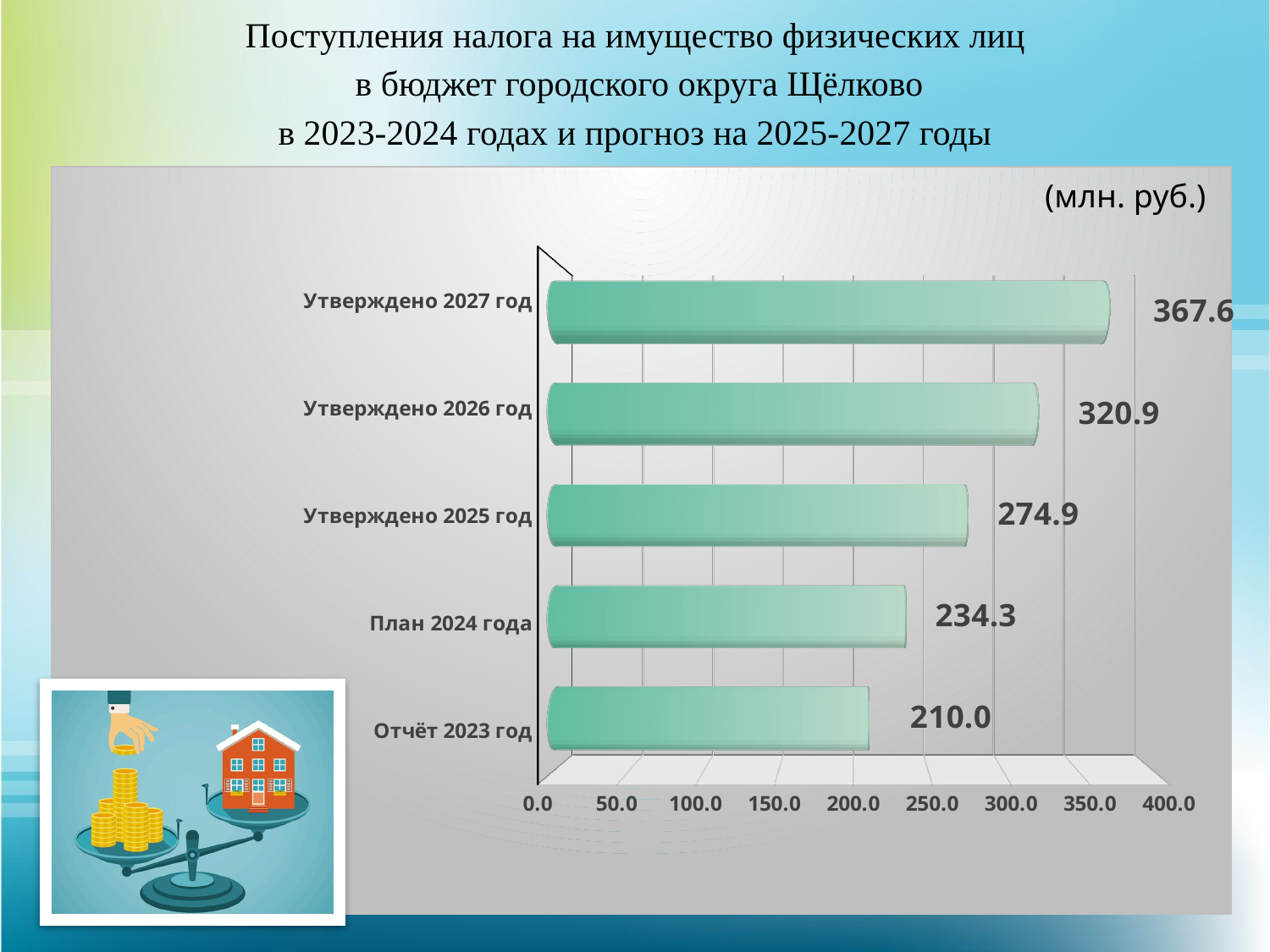
What unit of measurement is indicated for the chart values? млн. руб. What is the difference between the values for Утверждено 2027 год and Утверждено 2026 год? 46.7 What kind of chart is shown on the slide? bar chart Which category has the highest value? Утверждено 2027 год What is the value for Утверждено 2027 год? 367.6 Is the value for Утверждено 2026 год greater or less than 300.0? greater What is the value for Утверждено 2025 год? 274.9 How many categories are shown in the chart? 5 Which category has the lowest value? Отчёт 2023 год What is the value for План 2024 года? 234.3 What is the value for Отчёт 2023 год? 210.0 Which is larger, the value for План 2024 года or the value for Утверждено 2025 год? Утверждено 2025 год